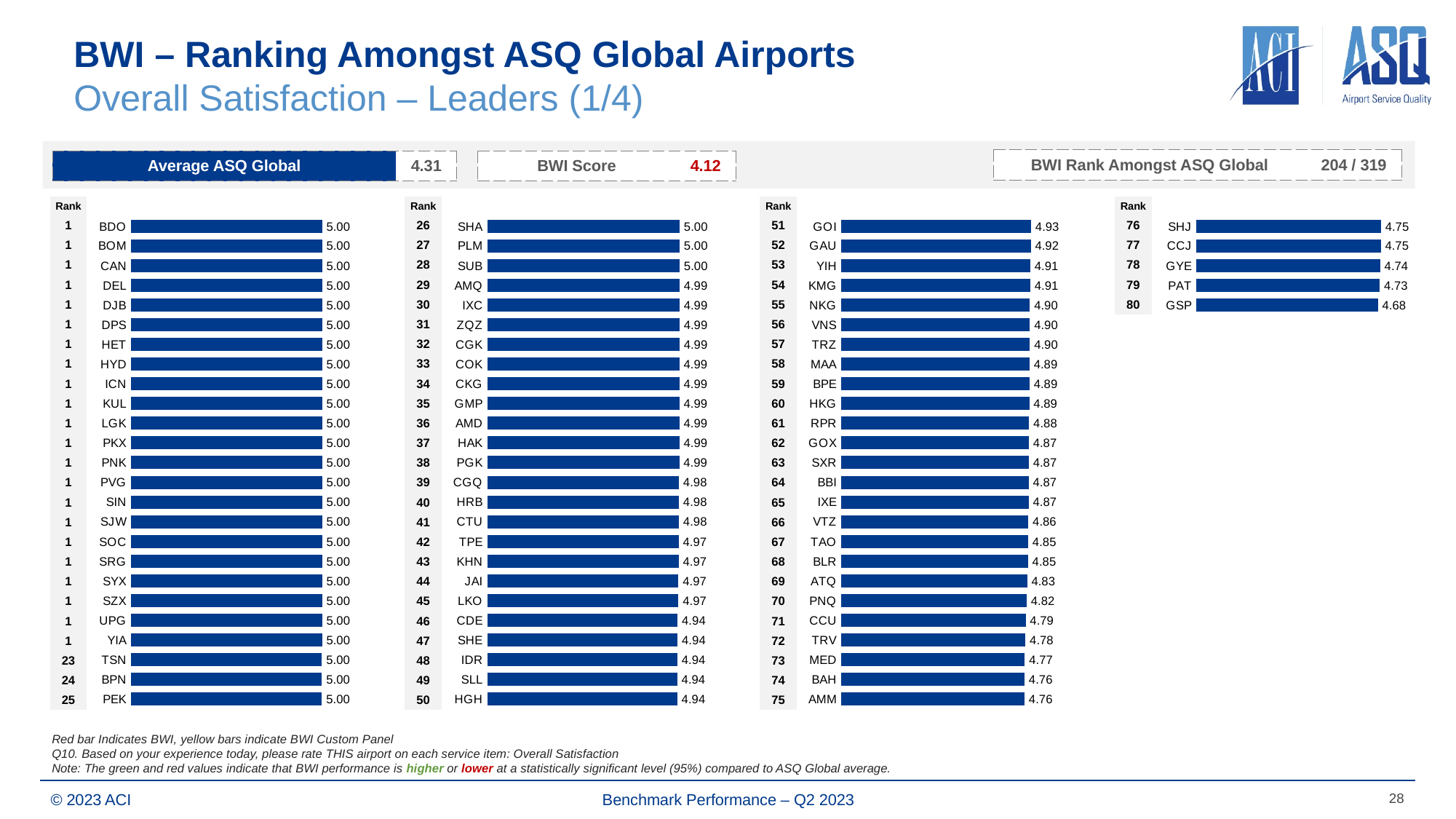
In the second chart from the left, what is the value for CGQ? 4.98 In the second chart from the left, which is larger, the value for TPE or the value for CDE? TPE In the third chart from the left, do the values rise or fall going from the top bar to the bottom bar? Fall In the third chart from the left, what is the value for ATQ? 4.83 In the third chart from the left, which category has the highest value? GOI What kind of chart is used on this slide? Bar chart In the rightmost chart, which category has the lowest value? GSP In the rightmost chart, what is the difference between the values for SHJ and GSP? 0.07 In the rightmost chart, what is the value for GSP? 4.68 How many categories are plotted in the rightmost chart? 5 In the third chart from the left, what is the difference between the values for GOI and AMM? 0.17 In the leftmost chart, what is the value for PEK? 5.00